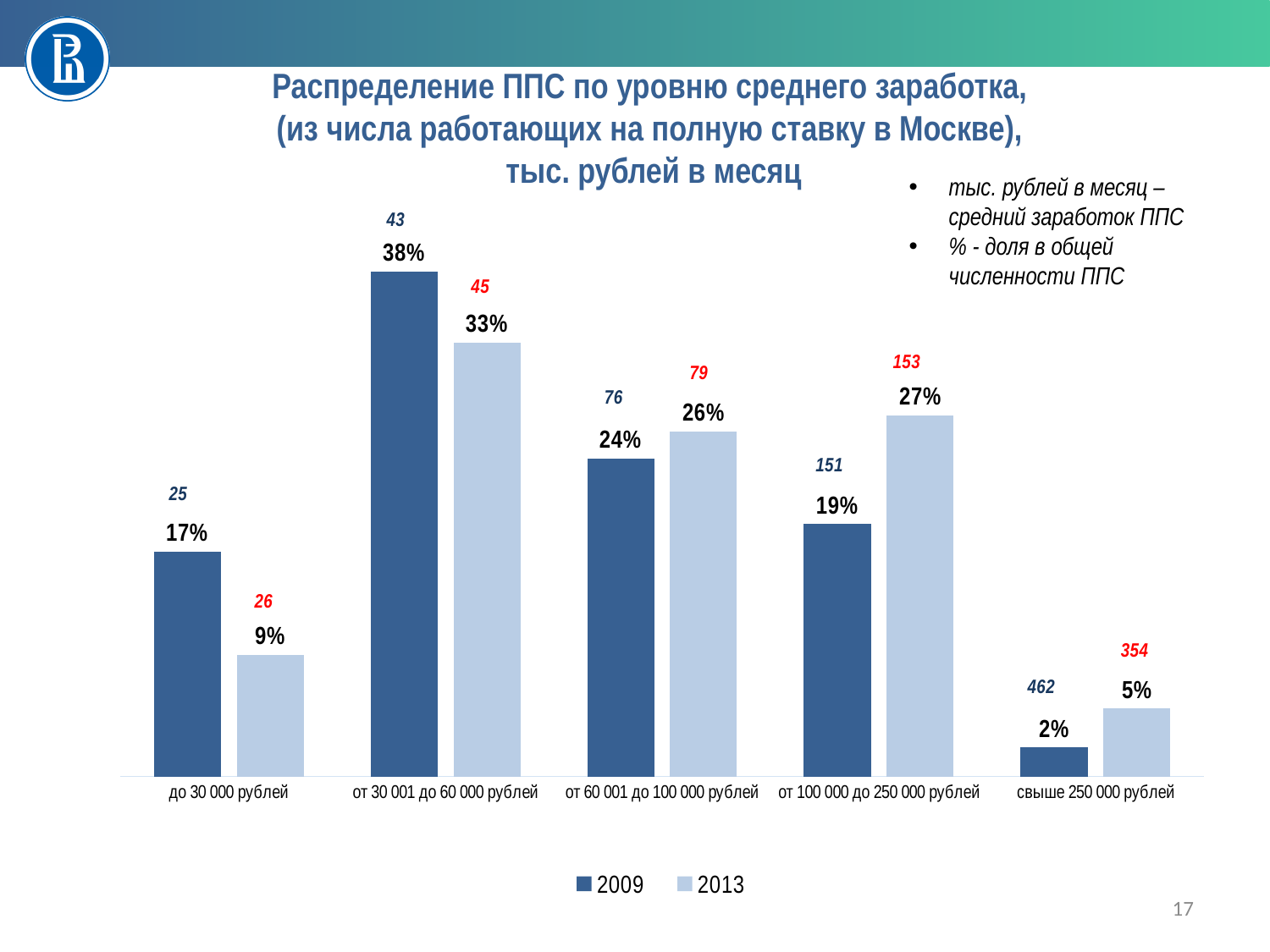
What is the difference between the 2009 and 2013 shares for 'до 30 000 рублей'? 8% What is the 2013 share for the category 'до 30 000 рублей'? 9% What is the 2013 share for the category 'от 100 000 до 250 000 рублей'? 27% Which category has the highest 2009 share? от 30 001 до 60 000 рублей Which colour represents the 2013 series in the legend? light blue What average salary (тыс. рублей в месяц) is shown above the 2013 bar for 'свыше 250 000 рублей'? 354 How many series does the legend list? 2 How many salary categories are shown on the x axis? 5 Which category has the lowest 2013 share? свыше 250 000 рублей What kind of chart is shown on the slide? bar chart What is the 2009 share for the category 'от 30 001 до 60 000 рублей'? 38% For 'от 60 001 до 100 000 рублей', which year has the larger share, 2009 or 2013? 2013